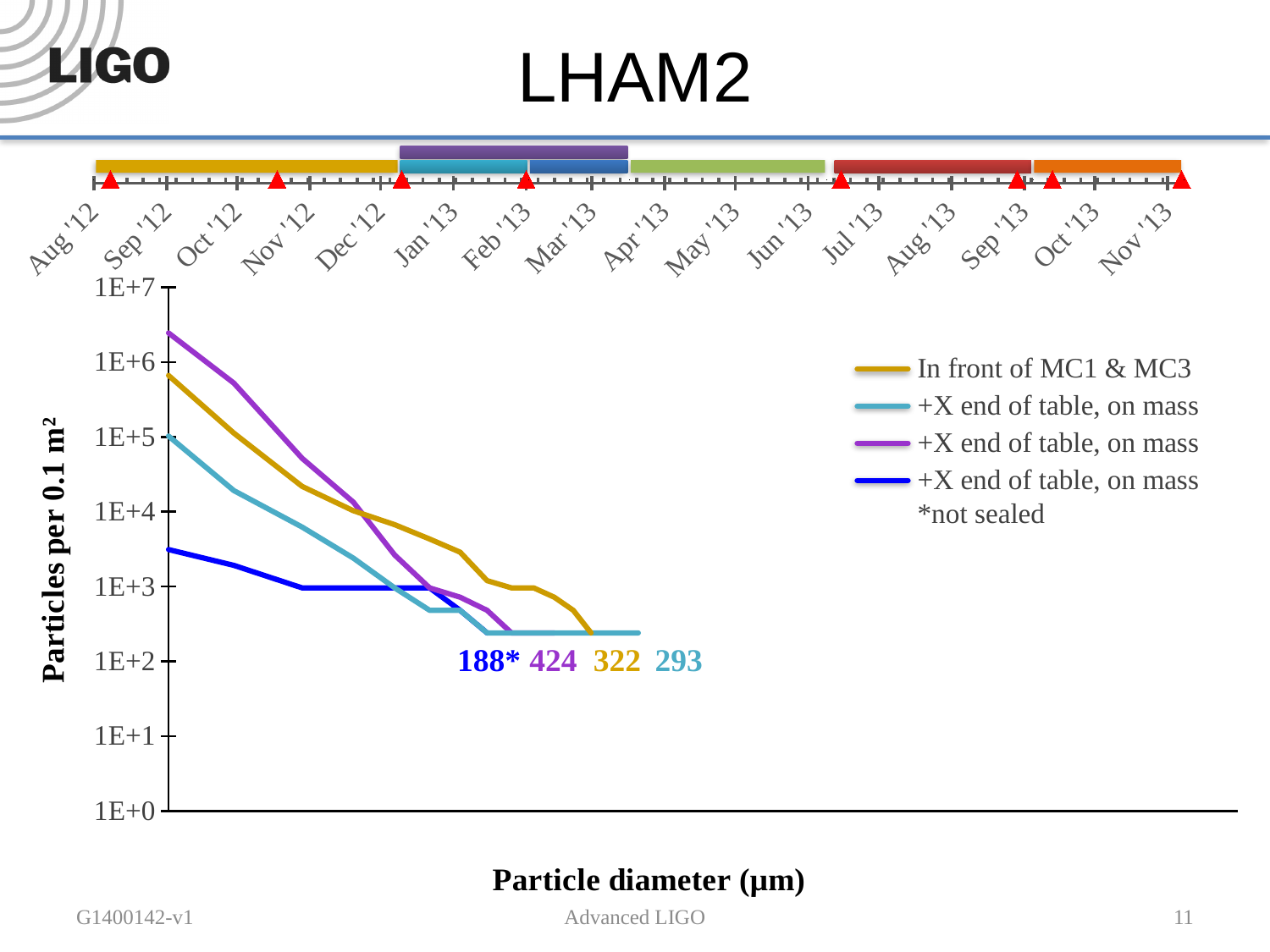
How many series does the legend list? 4 What kind of chart is shown on the slide? line chart What is the highest tick value shown on the y axis? 1E+7 Is the starting value of the purple '+X end of table, on mass' line greater or less than 1E+6? greater Which series has the highest value at the left end of the chart? +X end of table, on mass (purple) What is the label of the x axis? Particle diameter (µm) At the left end of the chart, which is larger: the purple line or the gold 'In front of MC1 & MC3' line? the purple line Do the plotted values rise or fall as particle diameter increases along the x axis? fall Is the starting value of the gold 'In front of MC1 & MC3' line greater or less than 1E+6? less Which series has the lowest value at the left end of the chart? +X end of table, on mass (blue) What is the label of the y axis? Particles per 0.1 m² Is the starting value of the blue '+X end of table, on mass' line greater or less than 1E+4? less